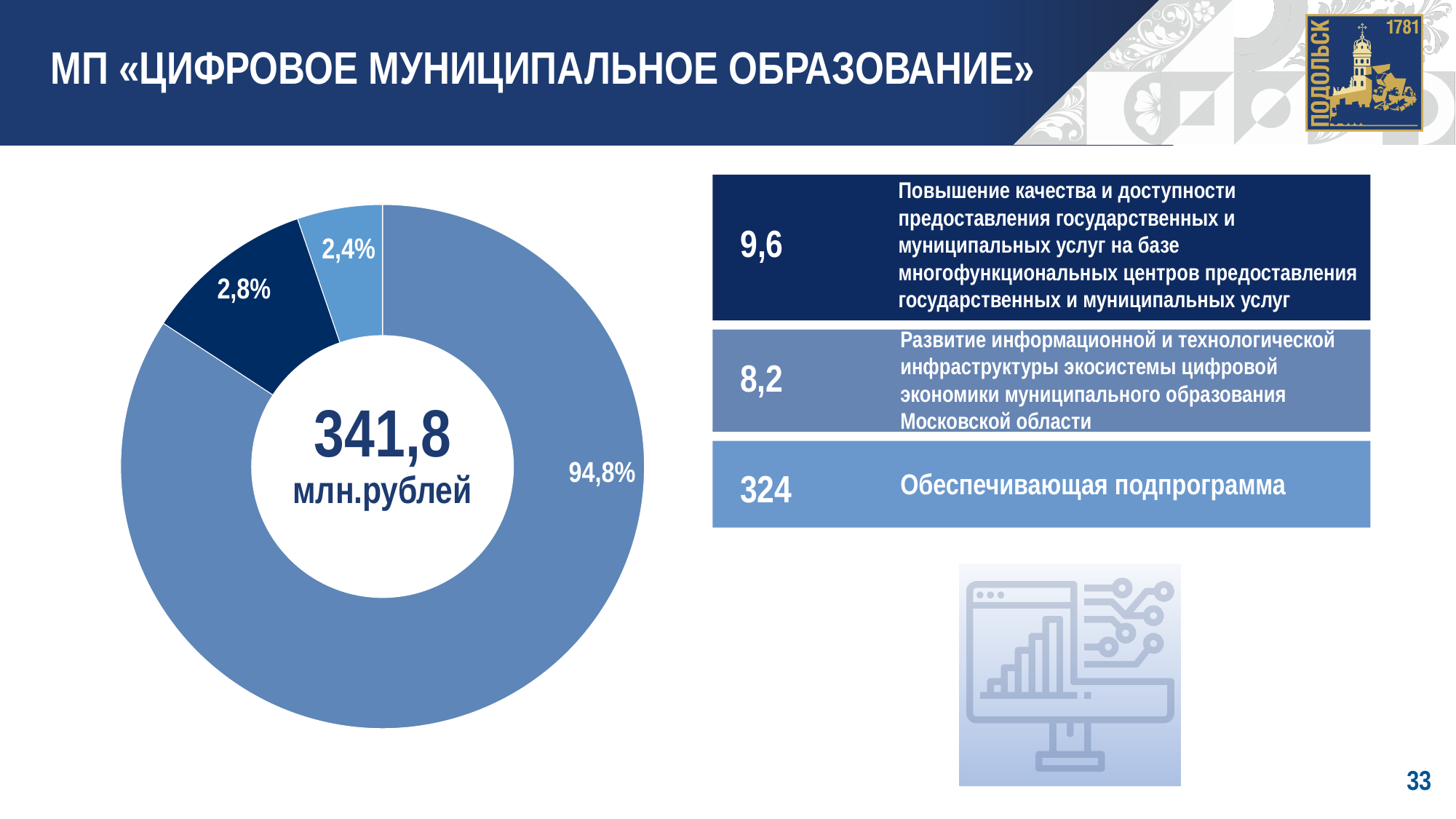
What total value is printed in the centre of the pie chart? 341,8 млн.рублей What is the share of the largest slice in the pie chart? 94,8% What value is shown next to «Обеспечивающая подпрограмма» in the boxes to the right of the chart? 324 What is the share of the smallest slice in the pie chart? 2,4% What do the three slice percentages of the pie chart add up to? 100% Is the largest slice of the pie chart greater or less than 90%? greater What is the difference between the 2,8% slice and the 2,4% slice? 0,4% What is the difference between the largest slice (94,8%) and the 2,8% slice? 92% Which is larger: the dark navy slice or the light blue slice? the dark navy slice (2,8%) What kind of chart is shown on the slide? doughnut chart What is the title of the slide containing the pie chart? МП «ЦИФРОВОЕ МУНИЦИПАЛЬНОЕ ОБРАЗОВАНИЕ» How many slices does the pie chart have? 3